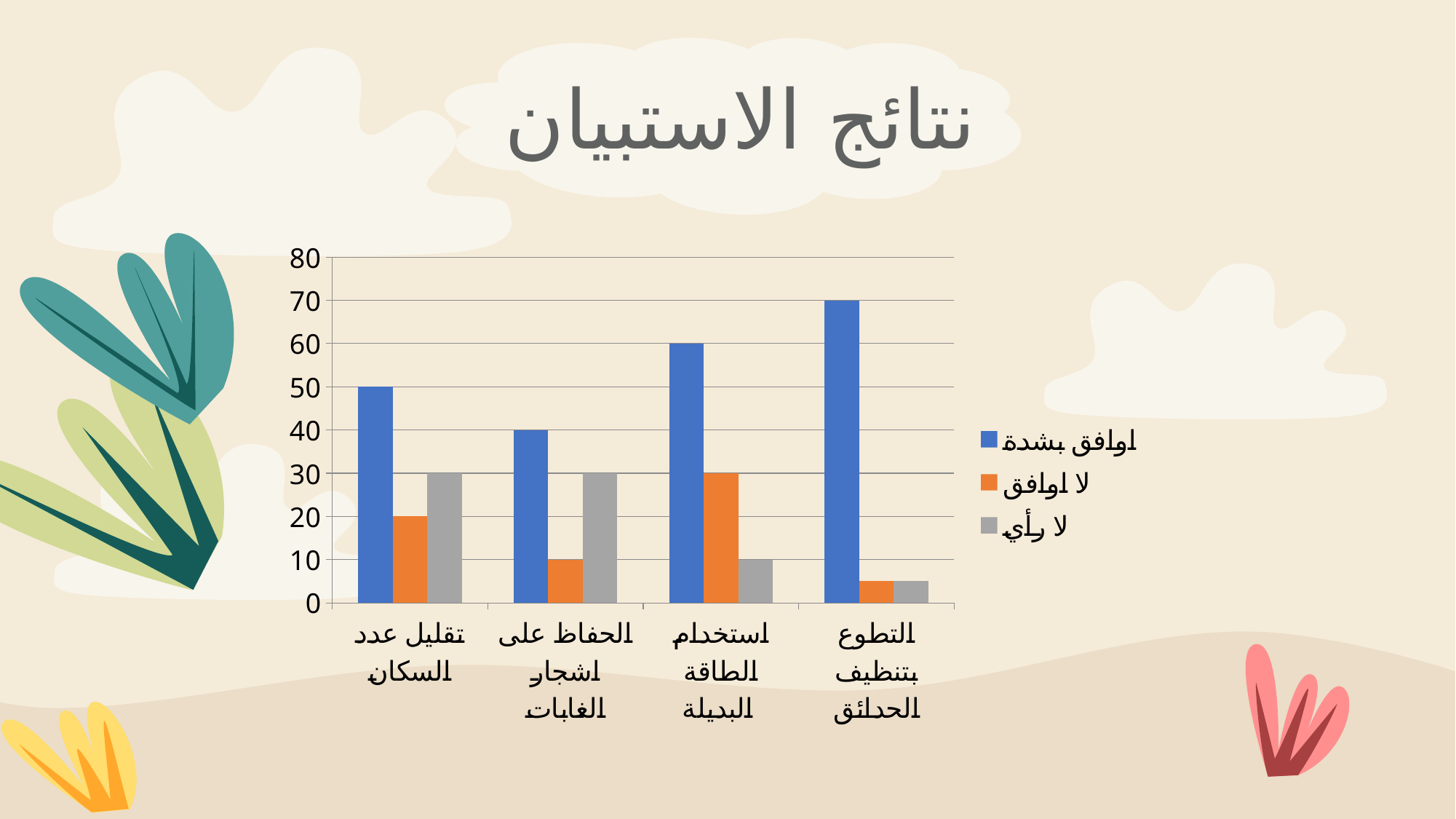
Is the "لا اوافق" value for "التطوع بتنظيف الحدائق" greater or less than 10? less Which category has the highest "اوافق بشدة" value? التطوع بتنظيف الحدائق Which category has the lowest "اوافق بشدة" value? الحفاظ على اشجار الغابات What is the value of "لا اوافق" for "استخدام الطاقة البديلة"? 30 How many series does the legend list? 3 What is the value of "لا رأي" for "الحفاظ على اشجار الغابات"? 30 What kind of chart is shown on the slide? bar chart What is the difference between the "اوافق بشدة" values for "التطوع بتنظيف الحدائق" and "تقليل عدد السكان"? 20 Which is larger for "تقليل عدد السكان": "لا اوافق" or "لا رأي"? لا رأي How many categories are shown on the x axis? 4 What is the value of "اوافق بشدة" for "تقليل عدد السكان"? 50 What is the value of "اوافق بشدة" for "التطوع بتنظيف الحدائق"? 70